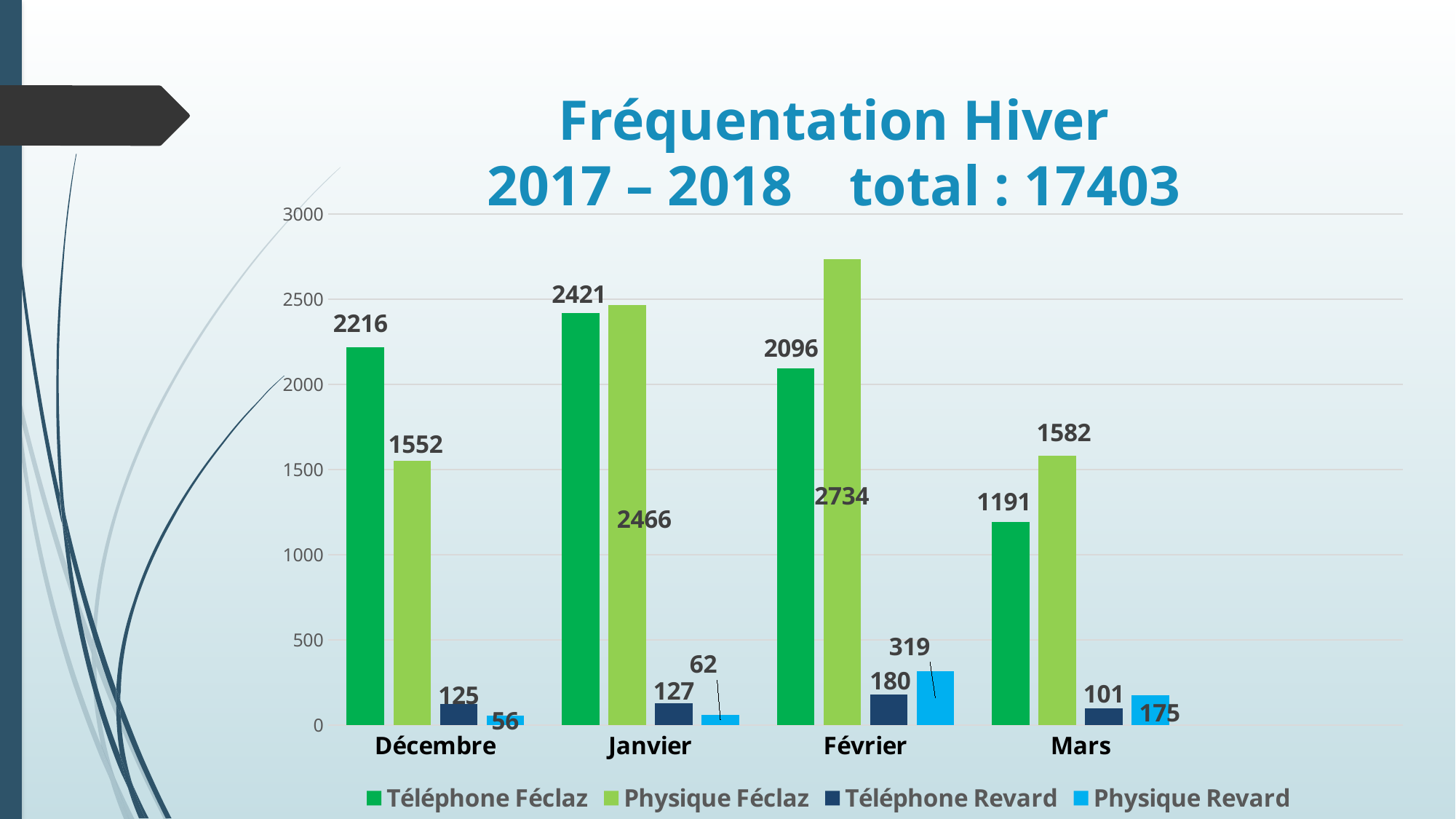
What is the value for Physique Revard in Janvier? 62 What total is stated in the chart title? 17403 What is the value for Physique Féclaz in Février? 2734 In which month is Physique Féclaz highest? Février In which month is Téléphone Féclaz lowest? Mars What is the value for Téléphone Féclaz in Décembre? 2216 What is the value for Téléphone Revard in Mars? 101 What is the difference between Physique Féclaz and Téléphone Féclaz in Mars? 391 How many months are shown on the x axis? 4 How many series does the legend list? 4 Which is larger in Janvier, Téléphone Féclaz or Physique Féclaz? Physique Féclaz What kind of chart is shown on the slide? Bar chart